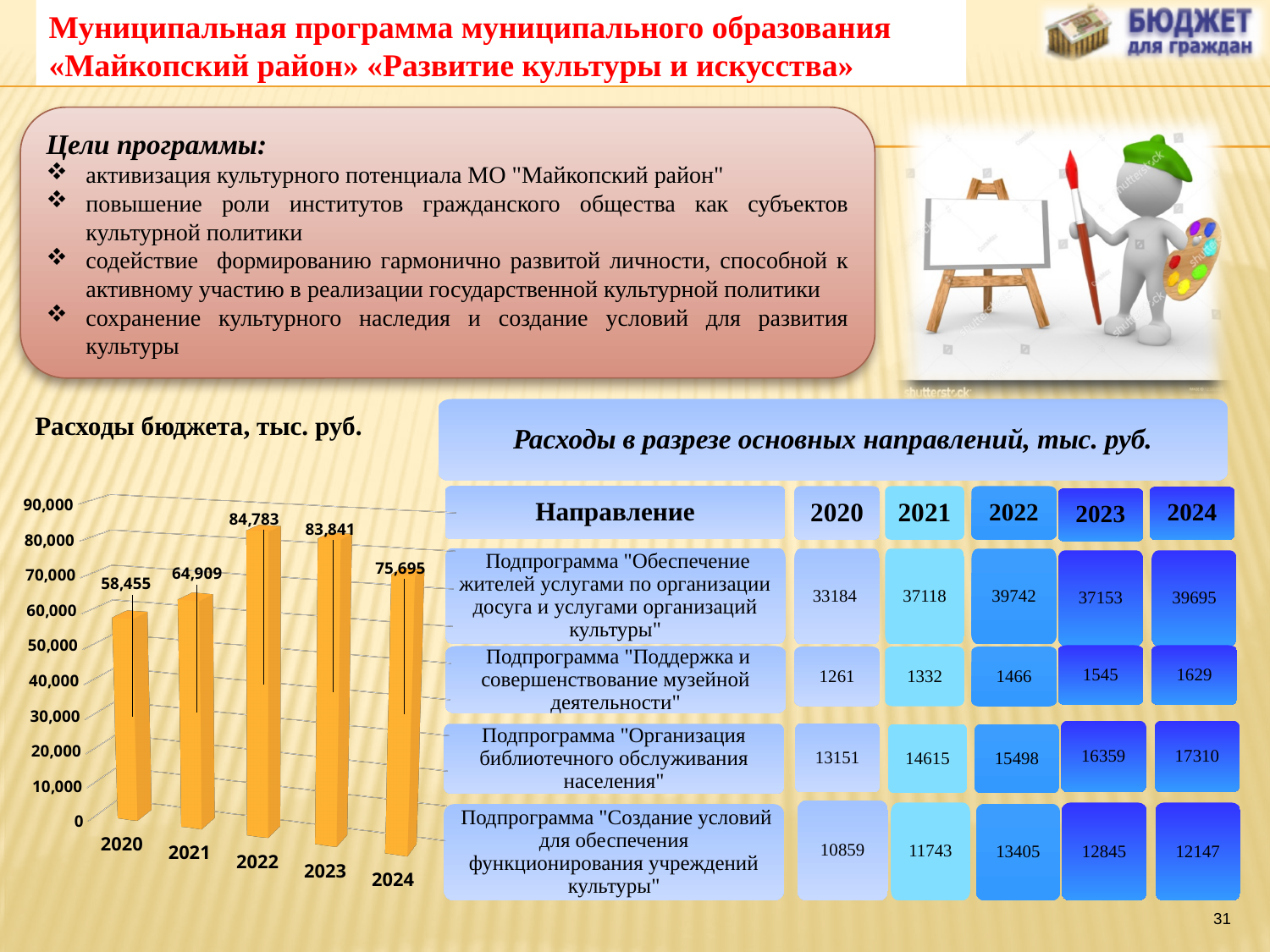
What is the value for 2020 in the 'Расходы бюджета, тыс. руб.' chart? 58,455 How many years are shown on the x axis of the 'Расходы бюджета, тыс. руб.' chart? 5 In the 'Расходы бюджета, тыс. руб.' chart, is the value for 2021 greater or less than 60,000? greater Which year has the highest value in the 'Расходы бюджета, тыс. руб.' chart? 2022 In the 'Расходы бюджета, тыс. руб.' chart, do the values rise or fall from 2020 to 2022? rise What is the value for 2024 in the 'Расходы бюджета, тыс. руб.' chart? 75,695 What kind of chart is 'Расходы бюджета, тыс. руб.'? bar chart What is the difference between the values for 2021 and 2020 in the 'Расходы бюджета, тыс. руб.' chart? 6,454 What is the value for 2022 in the 'Расходы бюджета, тыс. руб.' chart? 84,783 In the 'Расходы бюджета, тыс. руб.' chart, which is larger: the value for 2023 or the value for 2024? 2023 What is the difference between the values for 2022 and 2023 in the 'Расходы бюджета, тыс. руб.' chart? 942 Which year has the lowest value in the 'Расходы бюджета, тыс. руб.' chart? 2020